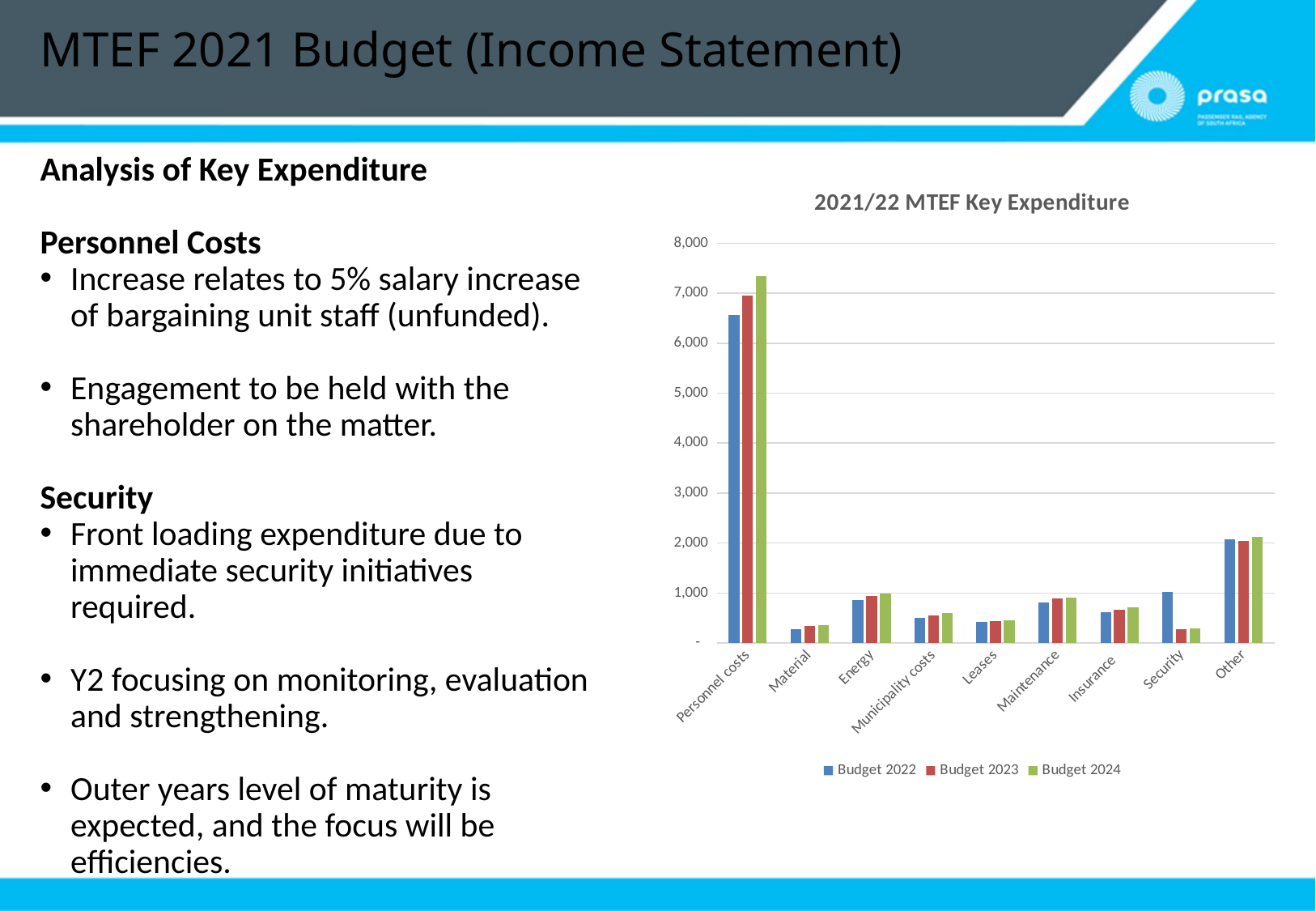
What kind of chart is shown on the slide? Bar chart Is the Budget 2022 value for Maintenance greater or less than 1,000? less Is the Budget 2023 value for Security greater or less than 1,000? less What is the title of the chart? 2021/22 MTEF Key Expenditure How many series does the chart legend list? 3 Which category has the highest Budget 2022 value? Personnel costs For Security, which is larger: the Budget 2022 value or the Budget 2023 value? Budget 2022 Which category has the lowest Budget 2022 value? Material For Personnel costs, do the values rise or fall from Budget 2022 to Budget 2024? rise Is the Budget 2022 value for Personnel costs greater or less than 6,000? greater How many expenditure categories are shown on the x axis of the chart? 9